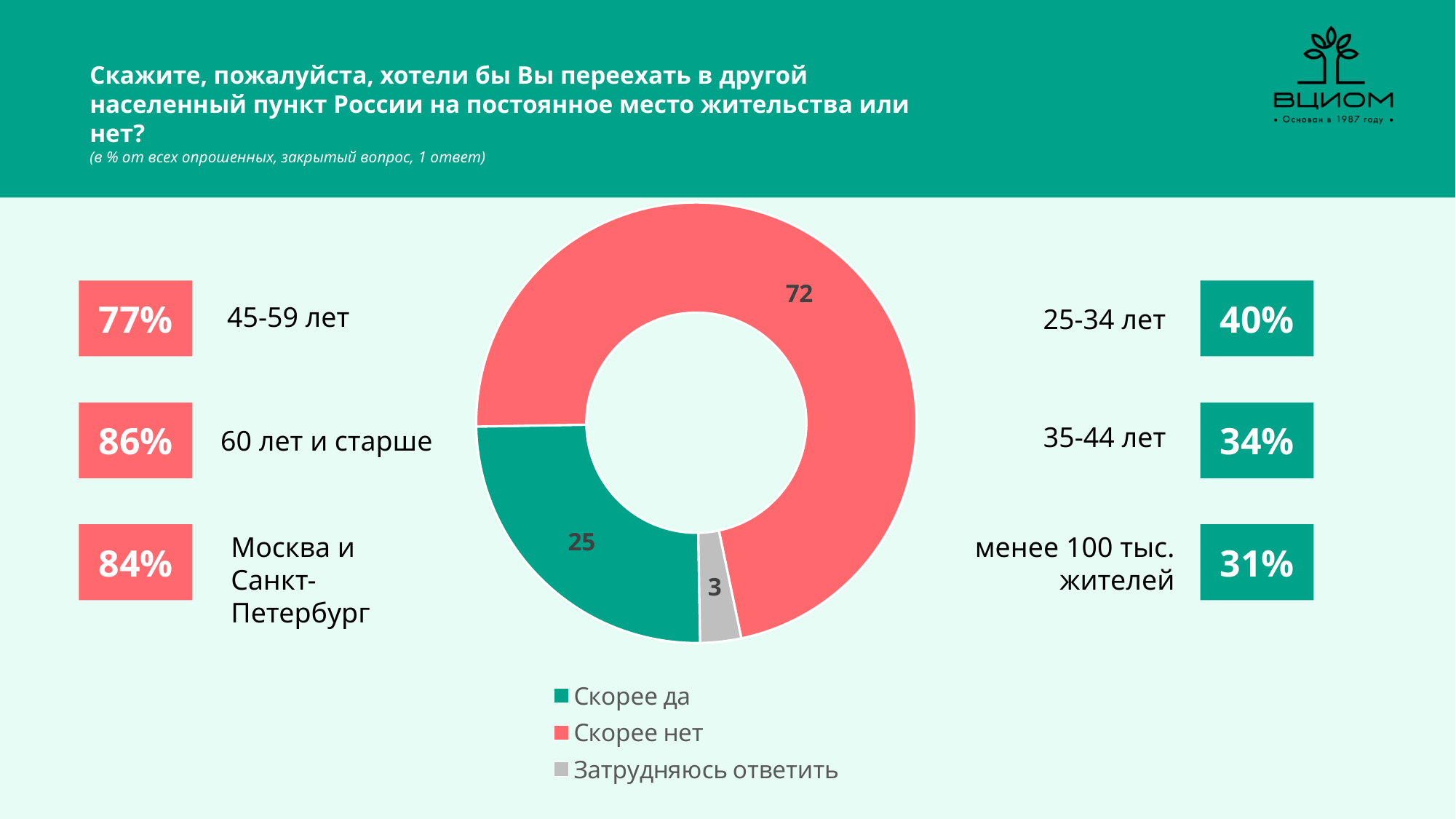
What is the value for "Скорее да" in the chart? 25 What colour is the "Скорее да" slice in the chart? Green How many entries does the chart legend list? 3 Which category has the largest slice in the chart? Скорее нет What is the difference between the values for "Скорее нет" and "Скорее да"? 47 Which is larger: the value for "Скорее да" or the value for "Затрудняюсь ответить"? Скорее да How many slices does the chart have? 3 Which category has the smallest slice in the chart? Затрудняюсь ответить What is the value for "Затрудняюсь ответить" in the chart? 3 What is the value for "Скорее нет" in the chart? 72 What colour is the "Затрудняюсь ответить" slice in the chart? Grey What kind of chart is shown on the slide? Pie chart (donut)